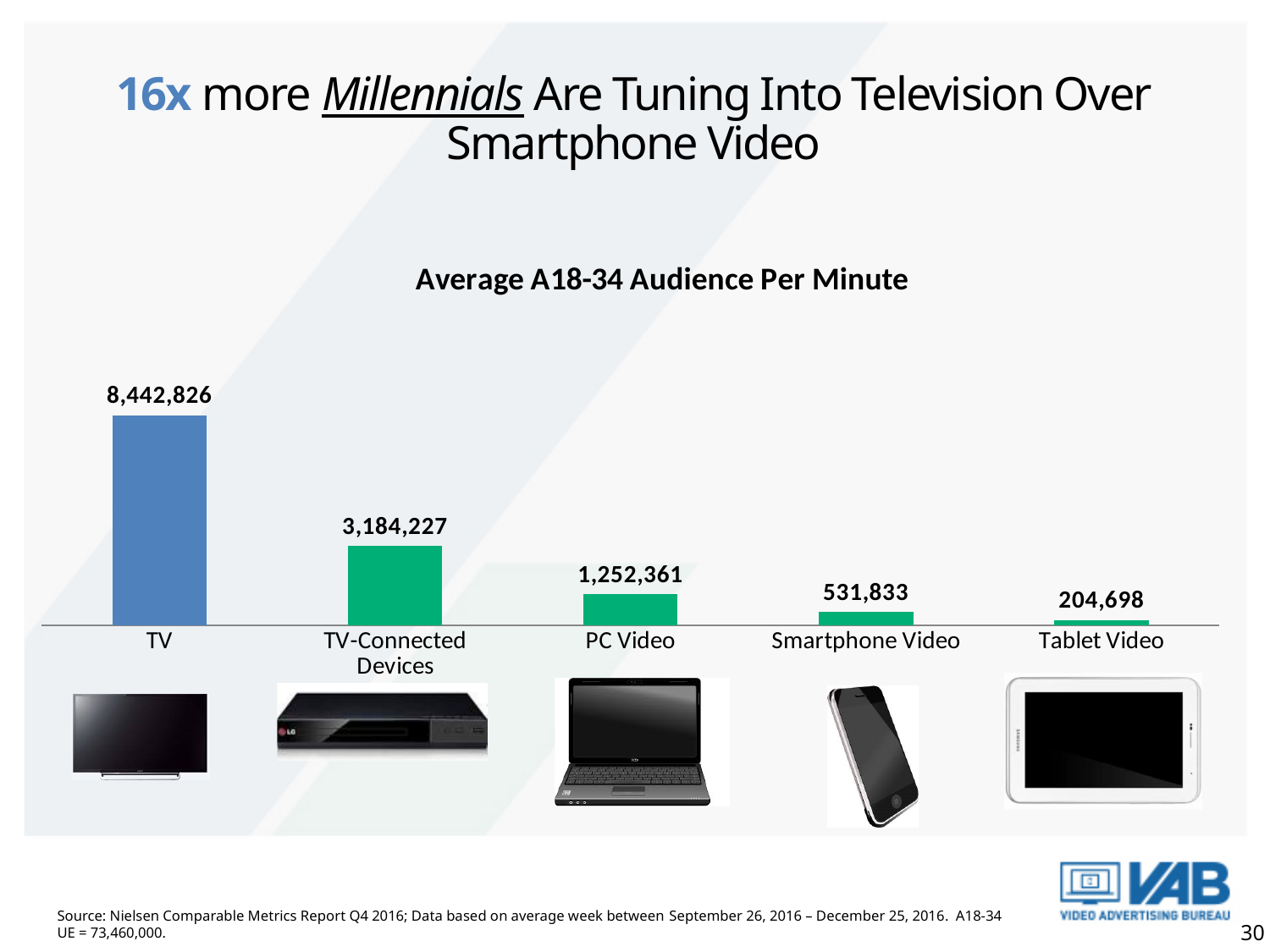
What is the average A18-34 audience per minute for PC Video? 1,252,361 How many categories are shown in the chart? 5 What is the average A18-34 audience per minute for Tablet Video? 204,698 What is the difference between the TV and Smartphone Video audience per minute values? 7,910,993 Which category has the highest average A18-34 audience per minute? TV What is the title of the chart? Average A18-34 Audience Per Minute What is the average A18-34 audience per minute for TV-Connected Devices? 3,184,227 What is the average A18-34 audience per minute for TV? 8,442,826 What is the average A18-34 audience per minute for Smartphone Video? 531,833 What kind of chart is shown on the slide? Bar chart Which category has the lowest average A18-34 audience per minute? Tablet Video Which is larger, the value for PC Video or the value for Smartphone Video? PC Video